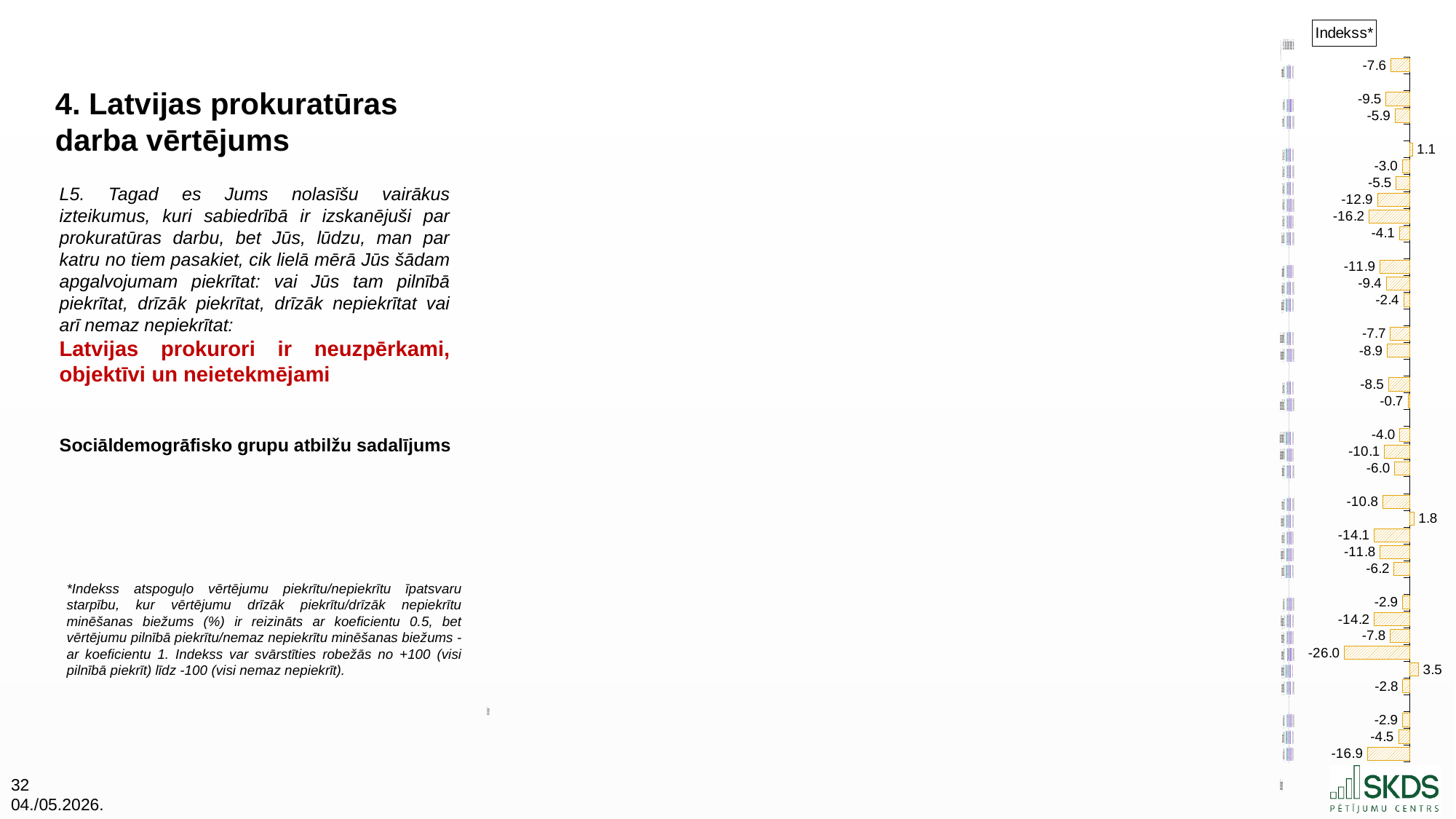
What is the lowest index value shown in the chart? -26.0 What is the title shown above the chart on the right? Indekss* Is the lowest value in the chart greater or less than -20? less What is the difference between the highest value (3.5) and the lowest value (-26.0) in the chart? 29.5 Which is larger, the highest positive value 3.5 or the value 1.8? 3.5 What kind of chart is shown on the right side of the slide? bar chart How many bars in the chart have a positive index value? 3 What is the highest index value shown in the chart? 3.5